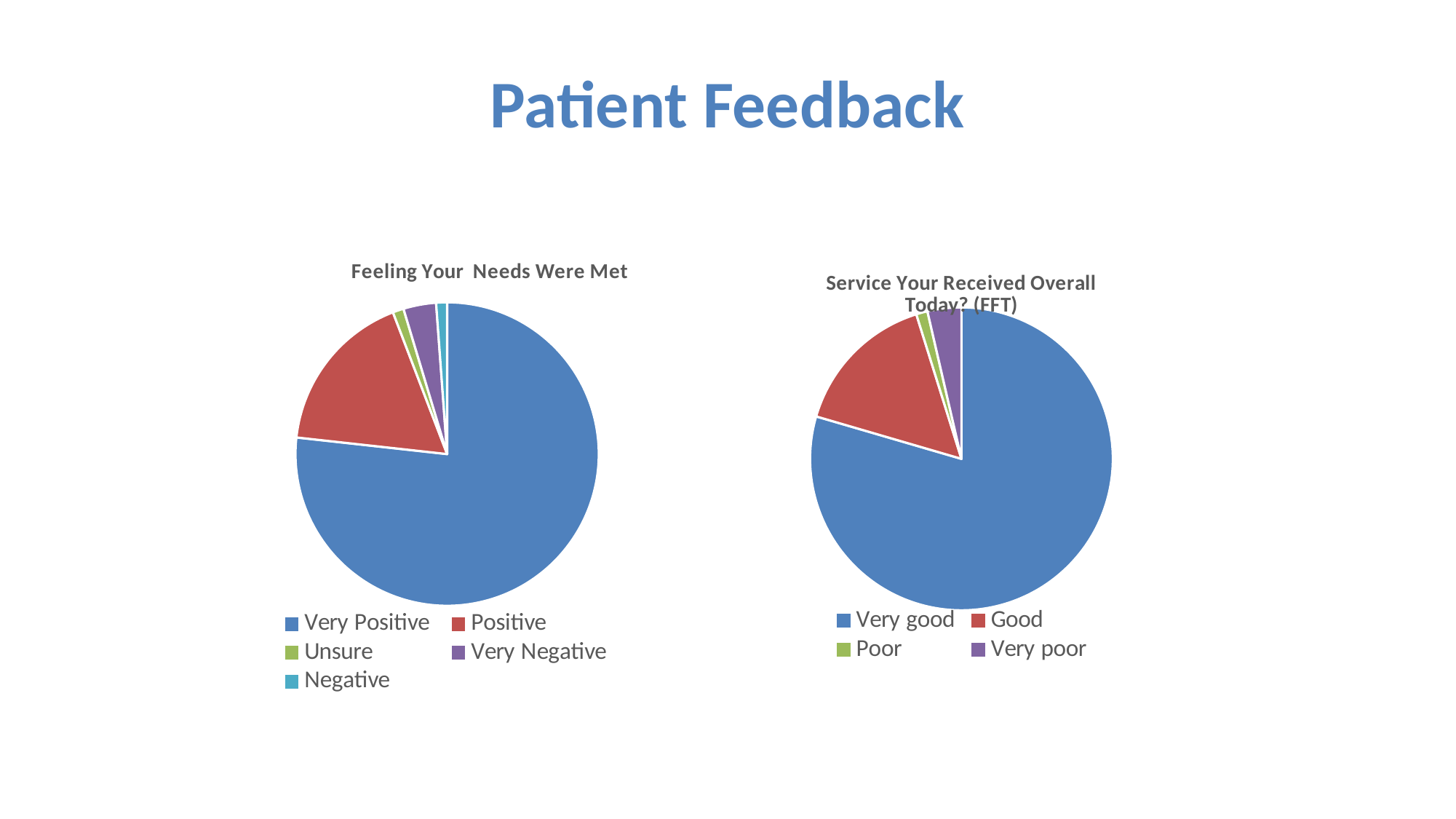
In the "Feeling Your Needs Were Met" chart, which category has the largest slice? Very Positive In the "Feeling Your Needs Were Met" chart, what colour is the Very Positive slice? blue In the "Feeling Your Needs Were Met" chart, which category is the second largest slice? Positive In the "Service Your Received Overall Today? (FFT)" chart, which is larger, the Good slice or the Very poor slice? Good How many categories does the legend of the "Service Your Received Overall Today? (FFT)" chart list? 4 What kind of chart is the "Service Your Received Overall Today? (FFT)" chart? pie chart In the "Feeling Your Needs Were Met" chart, which is larger, the Positive slice or the Unsure slice? Positive In the "Service Your Received Overall Today? (FFT)" chart, which category has the largest slice? Very good What is the title of the slide? Patient Feedback What kind of chart is the "Feeling Your Needs Were Met" chart? pie chart How many categories does the legend of the "Feeling Your Needs Were Met" chart list? 5